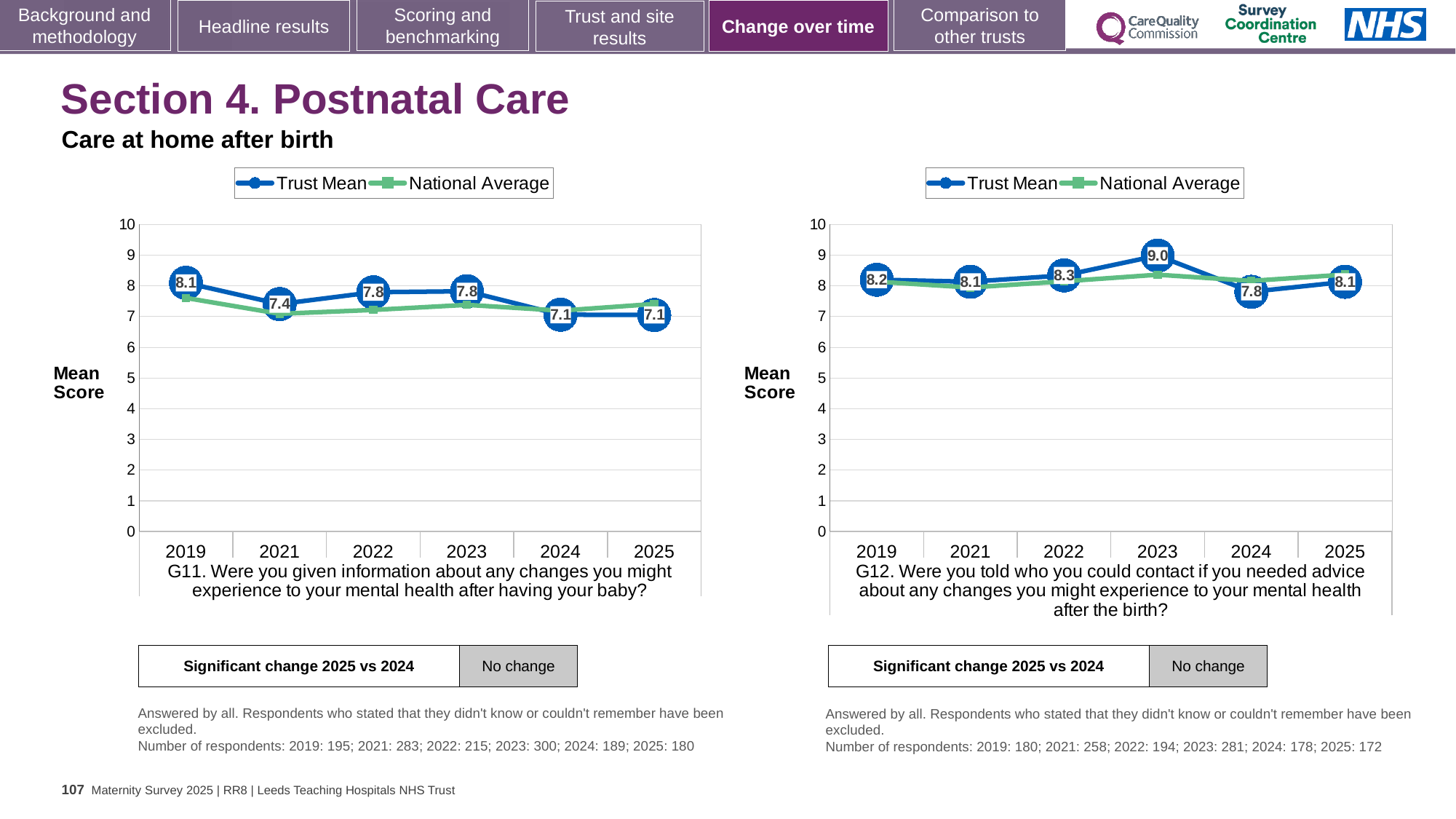
How many series does the legend of the G12 chart on the right list? 2 In the G12 chart on the right, what is the difference between the Trust Mean scores for 2023 and 2024? 1.2 In the G12 chart on the right, what is the Trust Mean score for 2024? 7.8 In the G12 chart on the right, which year has the highest Trust Mean score? 2023 In the G11 chart on the left, what is the Trust Mean score for 2025? 7.1 In the G12 chart on the right, what is the Trust Mean score for 2023? 9.0 In the G12 chart on the right, which year has the lowest Trust Mean score? 2024 In the G11 chart on the left, is the Trust Mean score for 2022 or 2024 higher? 2022 In the G11 chart on the left, what is the difference between the Trust Mean scores for 2019 and 2021? 0.7 In the G11 chart on the left, what is the Trust Mean score for 2019? 8.1 How many years are plotted on the x axis of the G11 chart on the left? 6 In the G11 chart on the left, which year has the highest Trust Mean score? 2019